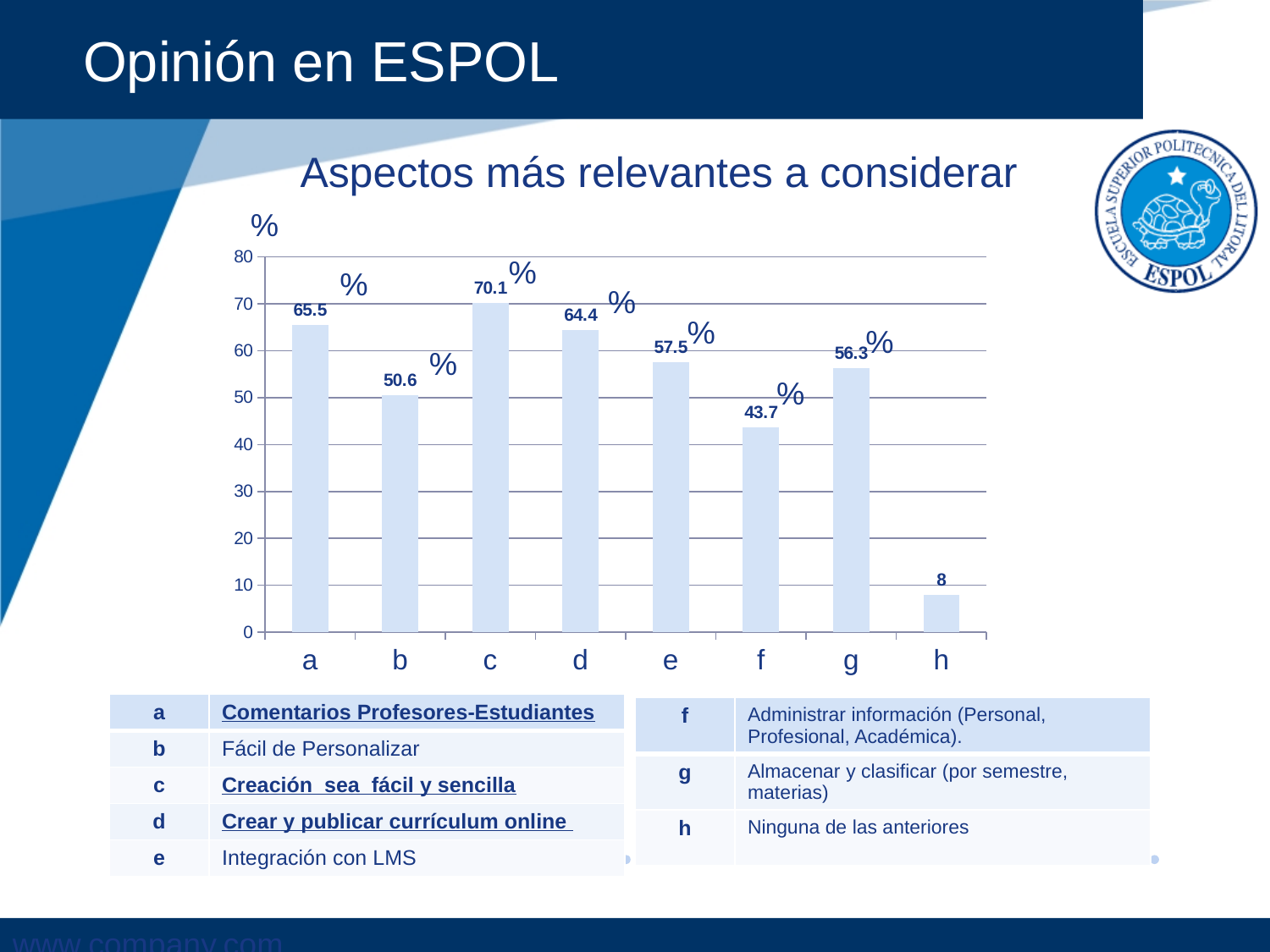
What is the difference between the values for a and b? 14.9 What type of chart is shown on the slide? bar chart What is the value for category c? 70.1 What is the value for category h? 8 Is the value for d greater or less than 60? greater Which category has the highest value? c Which category has the lowest value? h According to the table below the chart, what does category h stand for? Ninguna de las anteriores How many categories are shown on the x axis? 8 Which is larger, the value for e or the value for g? e What is the value for category f? 43.7 What is the title of the chart? Aspectos más relevantes a considerar